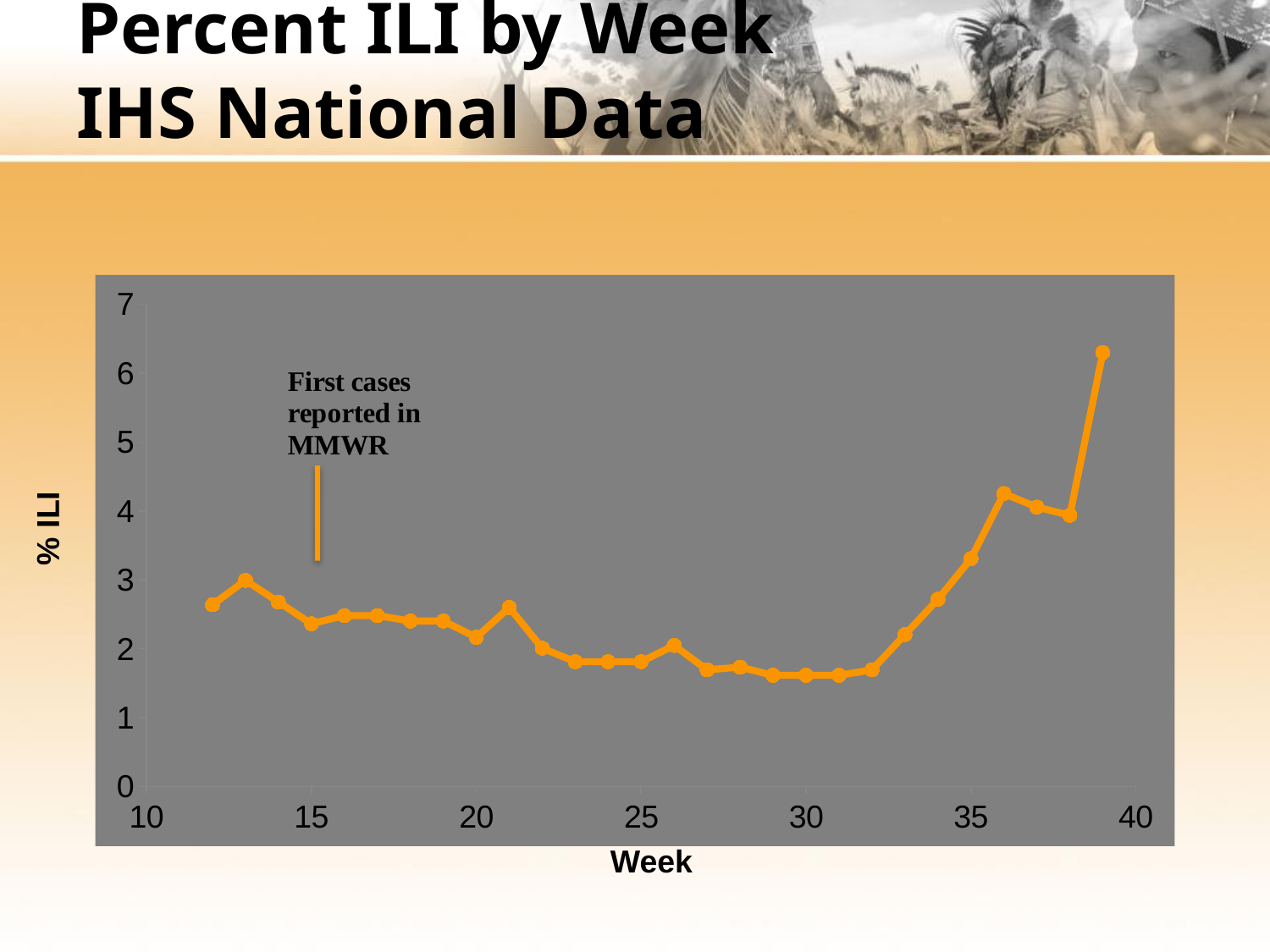
Is the % ILI value at week 30 greater or less than 2? less Is the % ILI value at week 36 greater or less than 4? greater Is the % ILI value at week 39 greater or less than 6? greater Which week has the higher % ILI, week 36 or week 39? Week 39 How many data points are plotted on the line? 28 Does the % ILI rise or fall from week 32 to week 39? Rise What event does the annotation near week 15 mark? First cases reported in MMWR Which week has the higher % ILI, week 12 or week 30? Week 12 What kind of chart is shown on the slide? Line chart At which week does the % ILI reach its highest value? Week 39